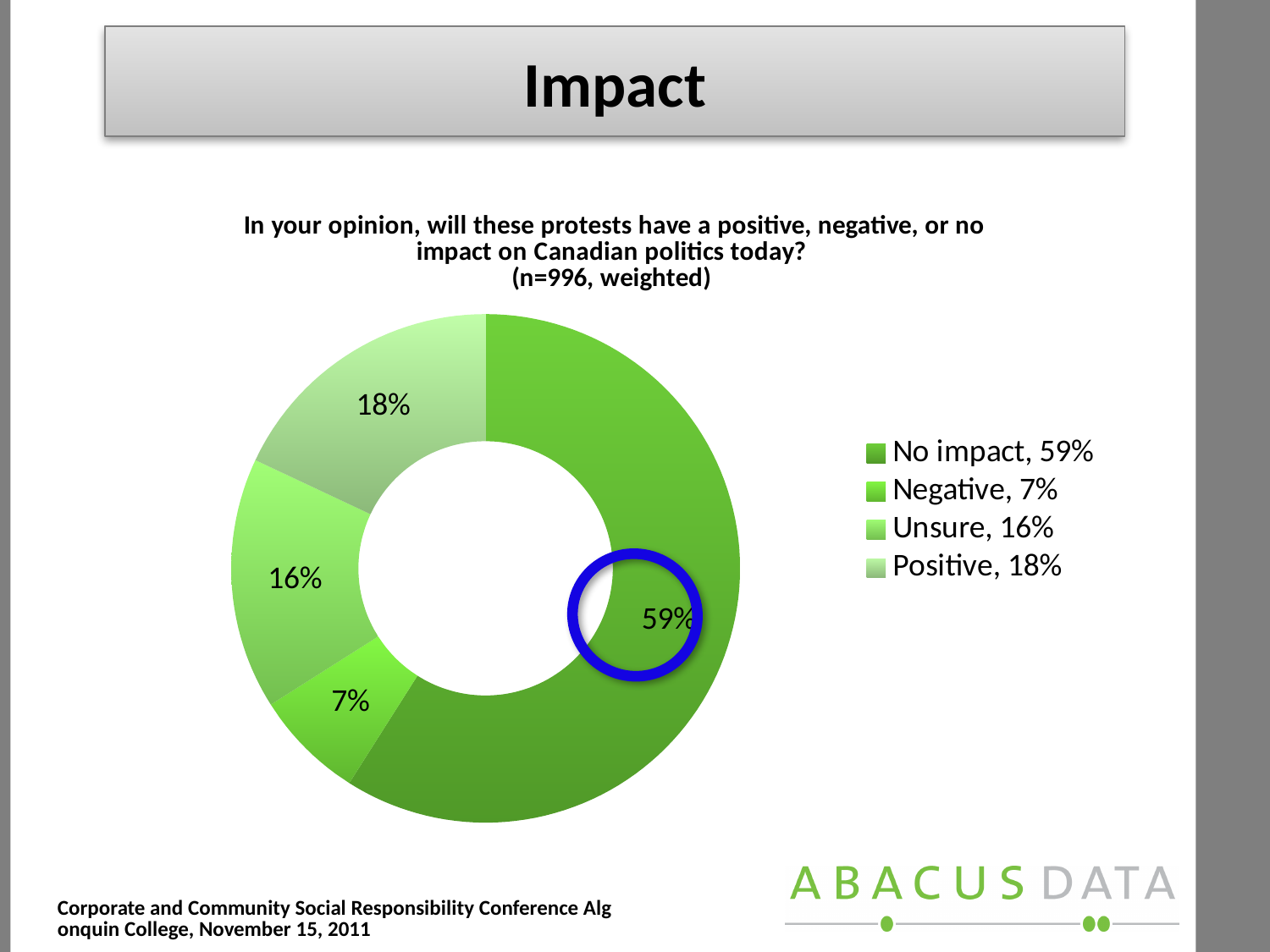
Which response category has the smallest share of the pie? Negative What is the difference in percentage points between the Positive and Negative responses? 11 What kind of chart is shown on the slide? Pie chart (doughnut) Which slice of the chart is highlighted with a blue circle? No impact, 59% Which is larger, the share for Positive or the share for Unsure? Positive What is the sample size stated in the chart title? n=996, weighted What percentage of respondents were unsure? 16% Which response category has the largest share of the pie? No impact How many response categories are shown in the chart? 4 What percentage of respondents said the protests will have a negative impact? 7% What percentage of respondents said the protests will have a positive impact? 18% What percentage of respondents said the protests will have no impact on Canadian politics? 59%